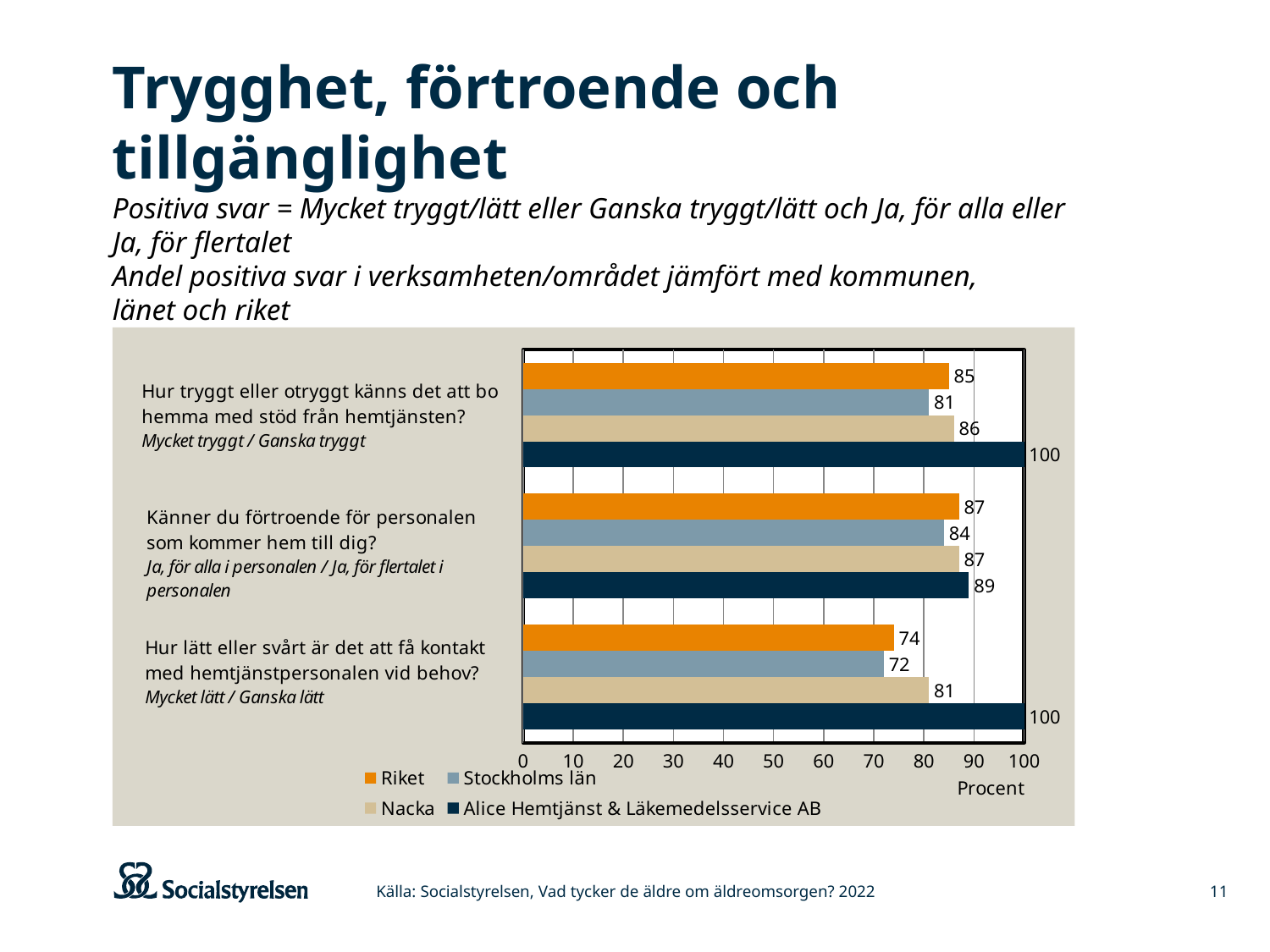
What is the value for Stockholms län on the question "Känner du förtroende för personalen som kommer hem till dig?"? 84 How many series does the legend list? 4 Which series has the lowest value on the question "Hur lätt eller svårt är det att få kontakt med hemtjänstpersonalen vid behov?"? Stockholms län How many question categories are plotted on the chart? 3 Which series has the highest value on the question "Hur tryggt eller otryggt känns det att bo hemma med stöd från hemtjänsten?"? Alice Hemtjänst & Läkemedelsservice AB What kind of chart is shown on the slide? Bar chart Which is larger on the question "Hur tryggt eller otryggt känns det att bo hemma med stöd från hemtjänsten?": the value for Nacka or the value for Stockholms län? Nacka What is the value for Nacka on the question "Hur lätt eller svårt är det att få kontakt med hemtjänstpersonalen vid behov?"? 81 What label is shown on the horizontal axis of the chart? Procent What is the difference between the Alice Hemtjänst & Läkemedelsservice AB value and the Riket value on the question "Hur lätt eller svårt är det att få kontakt med hemtjänstpersonalen vid behov?"? 26 What is the value for Riket on the question "Hur tryggt eller otryggt känns det att bo hemma med stöd från hemtjänsten?"? 85 What is the value for Alice Hemtjänst & Läkemedelsservice AB on the question "Känner du förtroende för personalen som kommer hem till dig?"? 89